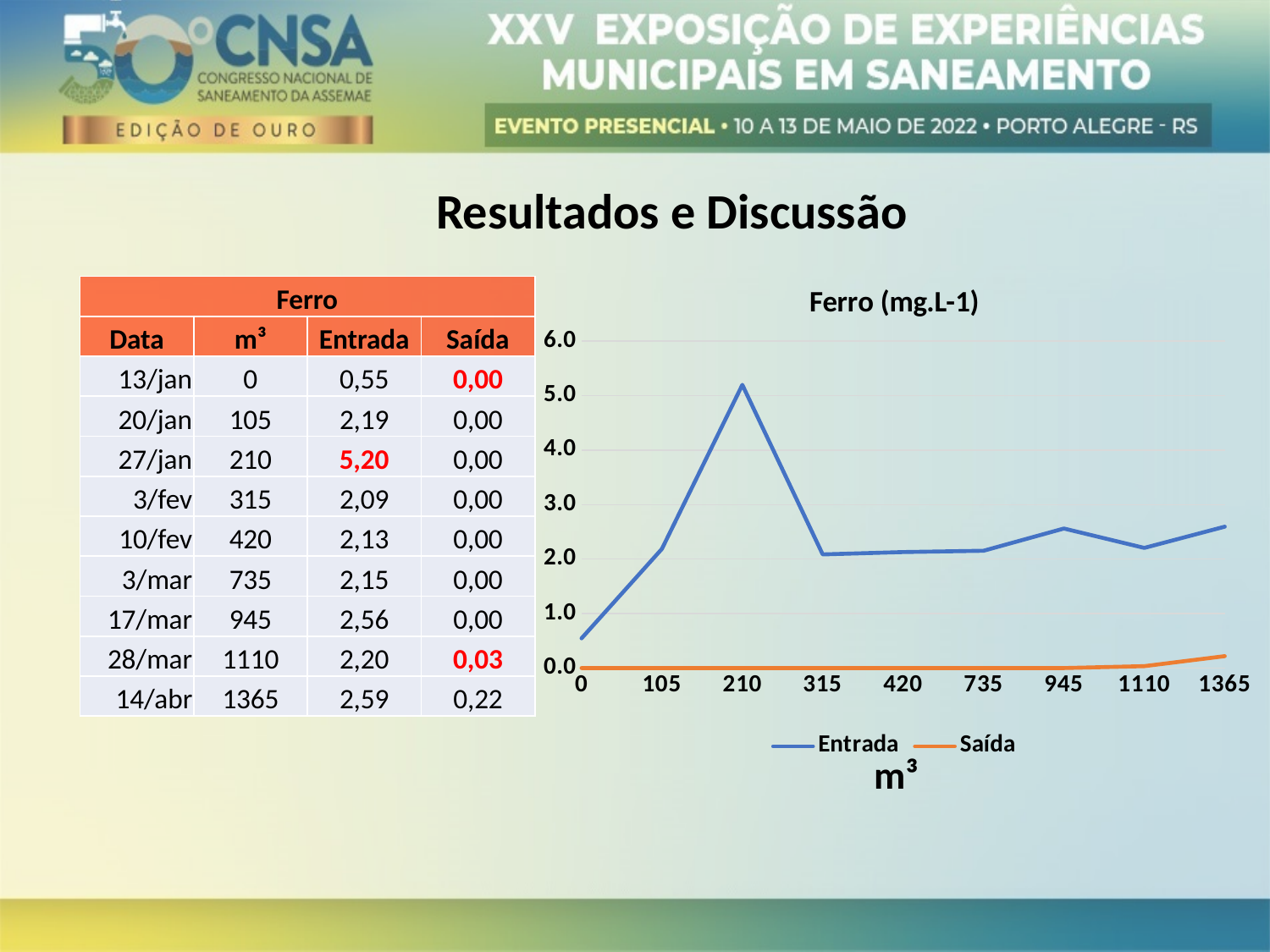
Is the Entrada value at 210 m³ greater or less than 4.0? greater Is the Entrada value at 0 m³ greater or less than 1.0? less What is the title of the chart? Ferro (mg.L-1) How many series does the legend of the chart list? 2 What is the difference between the Entrada value at 210 m³ and the Entrada value at 105 m³? 3,01 Does the Entrada series rise or fall between 0 m³ and 210 m³? rise How many points are plotted along the x axis of the chart? 9 At which m³ value does the Entrada series reach its highest point? 210 What is the Entrada value at 210 m³? 5,20 What kind of chart is shown on the slide? line chart At 945 m³, which series has the larger value, Entrada or Saída? Entrada What is the Saída value at 1365 m³? 0,22